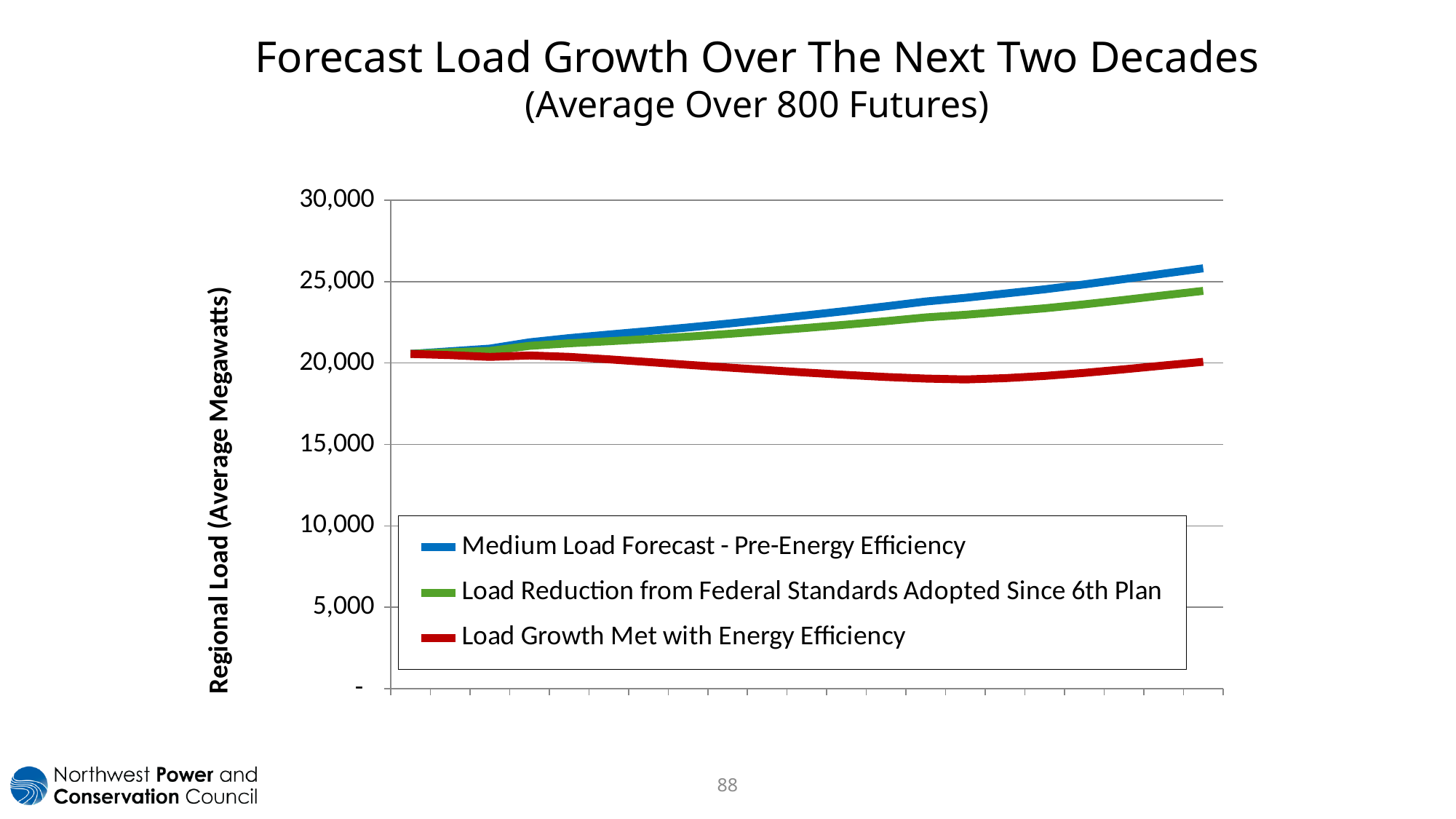
At the right end of the chart, which is larger: the Medium Load Forecast - Pre-Energy Efficiency line or the Load Growth Met with Energy Efficiency line? Medium Load Forecast - Pre-Energy Efficiency How many series does the legend list? 3 At the right end of the chart, is the Load Reduction from Federal Standards Adopted Since 6th Plan line greater or less than 25,000? less Which series has the highest value at the right end of the chart? Medium Load Forecast - Pre-Energy Efficiency Does the Load Reduction from Federal Standards Adopted Since 6th Plan line rise or fall along the x axis? Rises At the right end of the chart, is the Medium Load Forecast - Pre-Energy Efficiency line greater or less than 20,000? greater Which series has the lowest value at the right end of the chart? Load Growth Met with Energy Efficiency What is the title of the vertical axis? Regional Load (Average Megawatts) What kind of chart is shown on the slide? Line chart What colour is the Load Growth Met with Energy Efficiency line? Red Does the Medium Load Forecast - Pre-Energy Efficiency line rise or fall along the x axis? Rises At its lowest point, is the Load Growth Met with Energy Efficiency line greater or less than 20,000? less